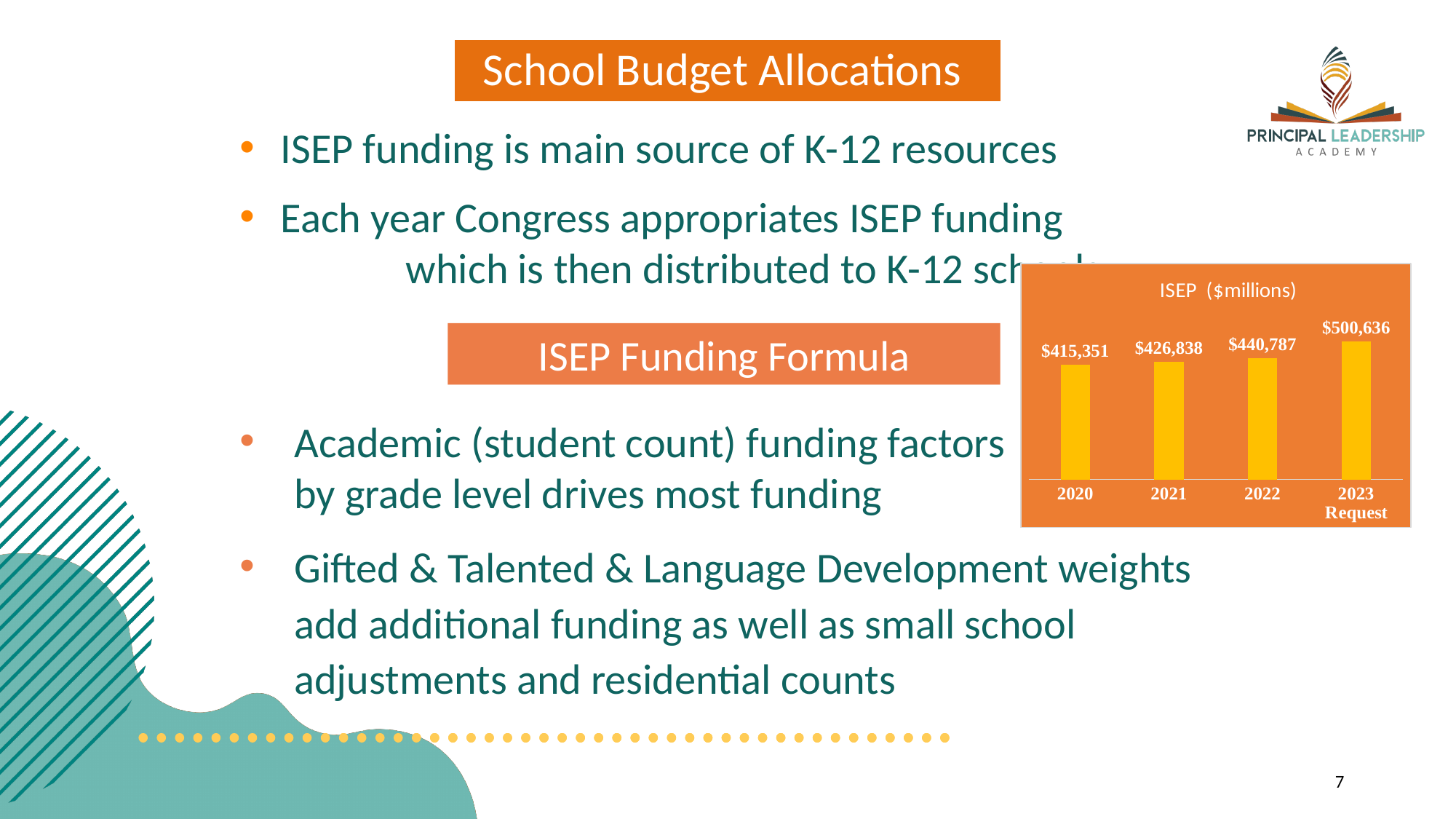
What is the difference between the 2023 Request and the 2022 ISEP values? $59,849 What is the ISEP value for 2022? $440,787 Which is larger, the ISEP value for 2022 or for 2021? 2022 What is the ISEP value for 2021? $426,838 Do the ISEP values rise or fall from 2020 to the 2023 Request? rise What kind of chart is the ISEP chart? bar chart Which category has the highest ISEP value? 2023 Request Which category has the lowest ISEP value? 2020 What is the ISEP value for the 2023 Request? $500,636 How many categories are shown on the ISEP chart? 4 What is the ISEP value for 2020? $415,351 What is the difference between the 2021 and 2020 ISEP values? $11,487